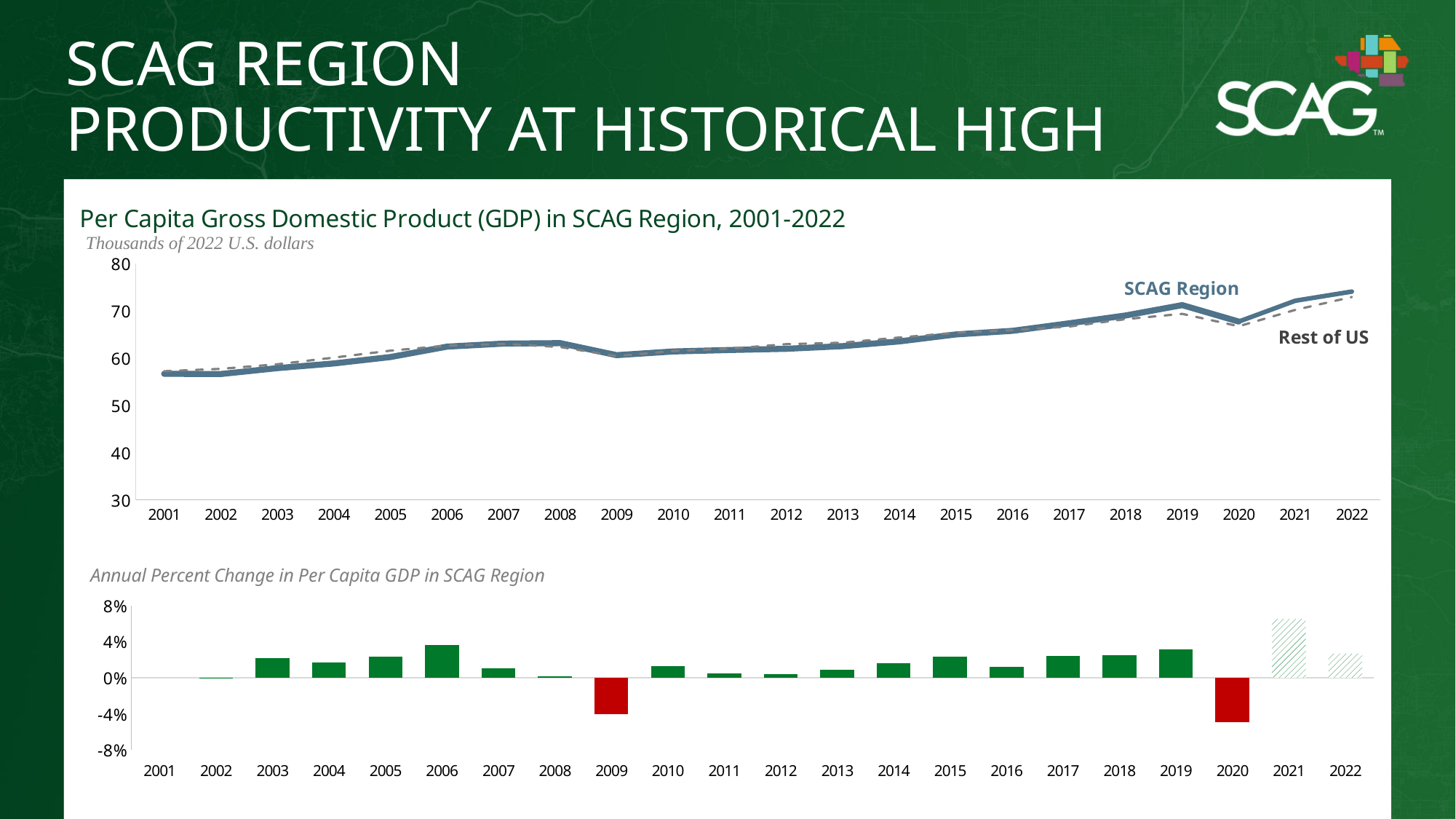
What kind of chart is the top chart, 'Per Capita Gross Domestic Product (GDP) in SCAG Region, 2001-2022'? Line chart In the bottom chart, which year has the highest annual percent change? 2021 In the top chart, how many years are shown on the x axis? 22 In the bottom chart, is the value for 2021 greater or less than 4%? greater In the top chart, how many series are plotted? 2 In the top chart, what are the names of the two series? SCAG Region and Rest of US In the top chart, does the SCAG Region per capita GDP generally rise or fall from 2001 to 2022? Rise In the top chart, which year has the highest SCAG Region per capita GDP? 2022 In the top chart, is the SCAG Region value for 2022 greater or less than 70? greater What kind of chart is the bottom chart, 'Annual Percent Change in Per Capita GDP in SCAG Region'? Bar chart In the top chart, is the SCAG Region value for 2001 greater or less than 60? less In the bottom chart, which year has the lowest annual percent change? 2020